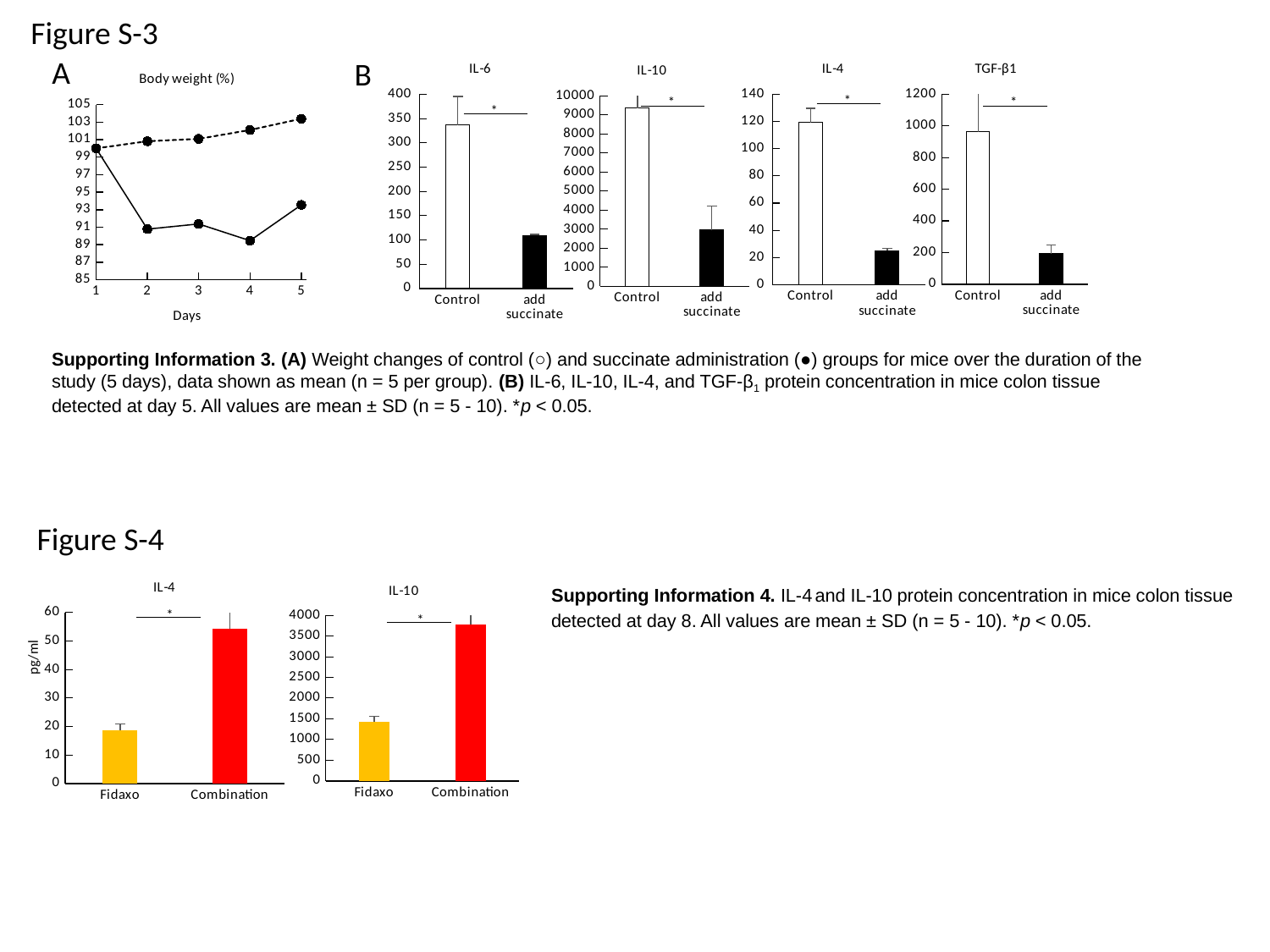
In the IL-4 chart of Figure S-4, is the value for Fidaxo greater or less than 30? less In the IL-6 chart of Figure S-3, is the value for Control greater or less than 300? greater In the IL-6 chart of Figure S-3, which bar is higher, Control or add succinate? Control In the IL-10 chart of Figure S-3, is the value for add succinate greater or less than 4000? less In Figure S-3, how many days are shown on the x axis of the Body weight (%) chart? 5 In Figure S-3, what kind of chart is the Body weight (%) chart? line chart In the IL-4 chart of Figure S-4, which bar is higher, Fidaxo or Combination? Combination In Figure S-3, does the dashed line in the Body weight (%) chart rise or fall from day 1 to day 5? rise In the IL-4 chart of Figure S-4, what is the y-axis label? pg/ml